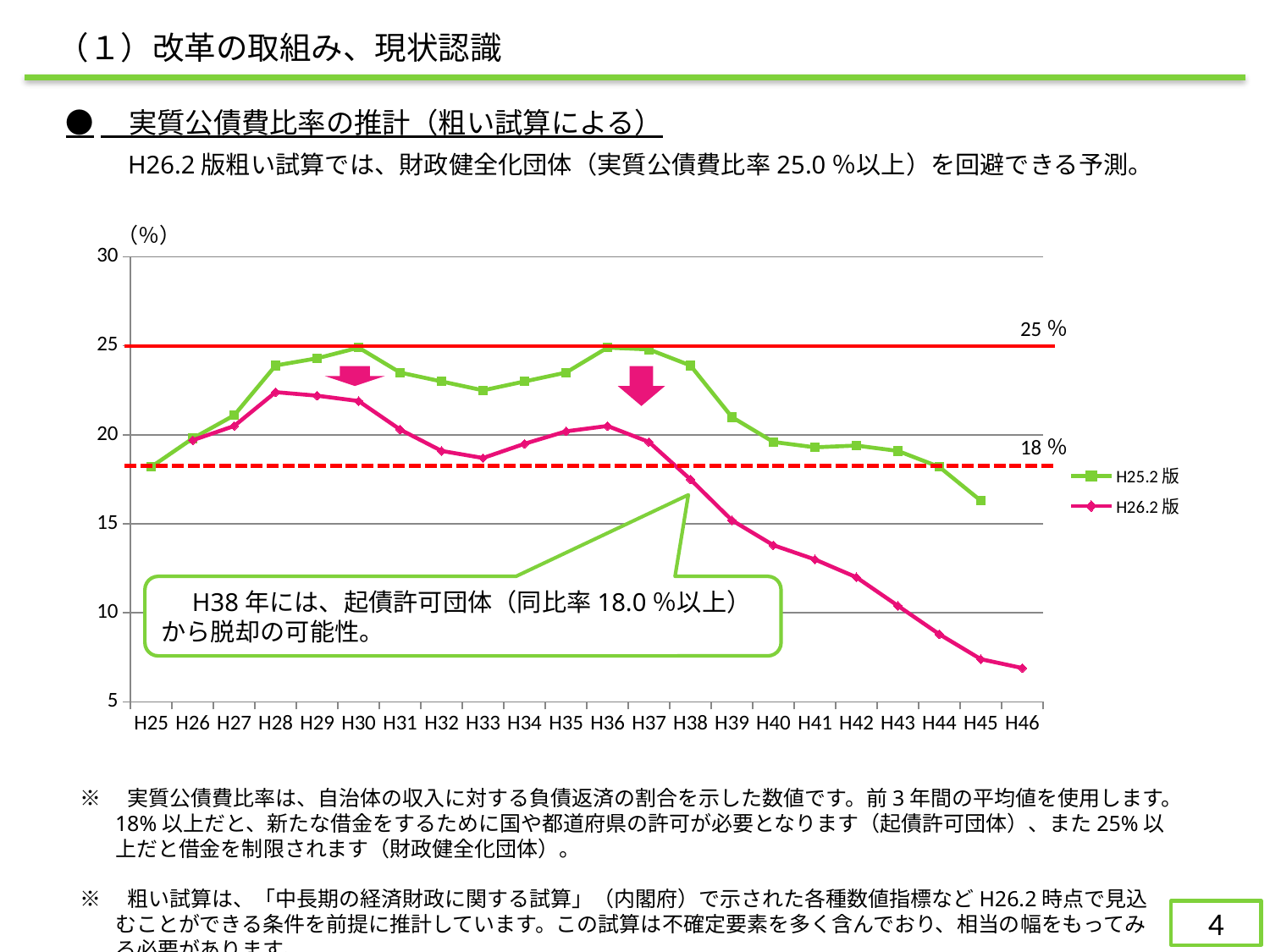
Is the value of the H25.2版 series at H45 greater or less than 15? greater What value does the solid red horizontal line mark? 25% How many fiscal-year categories are shown on the x axis? 22 Is the value of the H26.2版 series at H46 greater or less than 10? less Is the value of the H25.2版 series at H30 greater or less than 20? greater What type of chart is shown on the slide? line chart How many series does the legend list? 2 At H40, which series has the higher value, H25.2版 or H26.2版? H25.2版 Does the H26.2版 series rise or fall from H38 to H46? fall What are the two series named in the legend? H25.2版 and H26.2版 At which year does the H26.2版 series reach its lowest value? H46